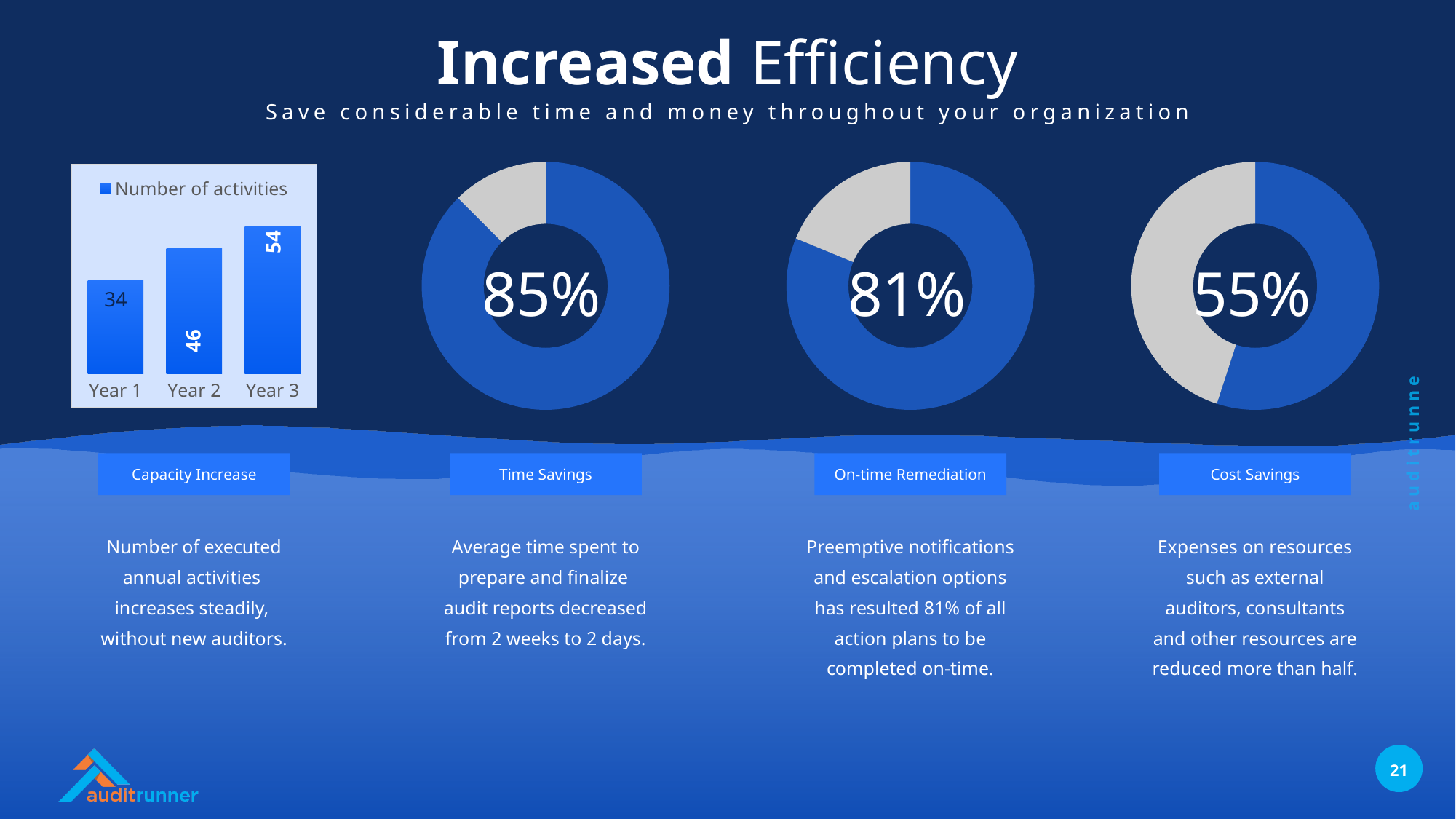
In the bar chart on the left, which year has the lowest number of activities? Year 1 What percentage is shown in the centre of the donut chart above the 'Cost Savings' label? 55% In the bar chart on the left, which year has the highest number of activities? Year 3 How many years are shown in the bar chart on the left? 3 In the bar chart on the left, what is the difference in number of activities between Year 3 and Year 1? 20 What percentage is shown in the centre of the donut chart above the 'Time Savings' label? 85% What kind of chart is the chart on the left of the slide? Bar chart What series name does the legend of the bar chart on the left show? Number of activities In the bar chart on the left, do the values rise or fall from Year 1 to Year 3? Rise In the bar chart on the left, what is the number of activities for Year 3? 54 In the bar chart on the left, what is the number of activities for Year 1? 34 In the bar chart on the left, is the number of activities larger in Year 2 or Year 1? Year 2